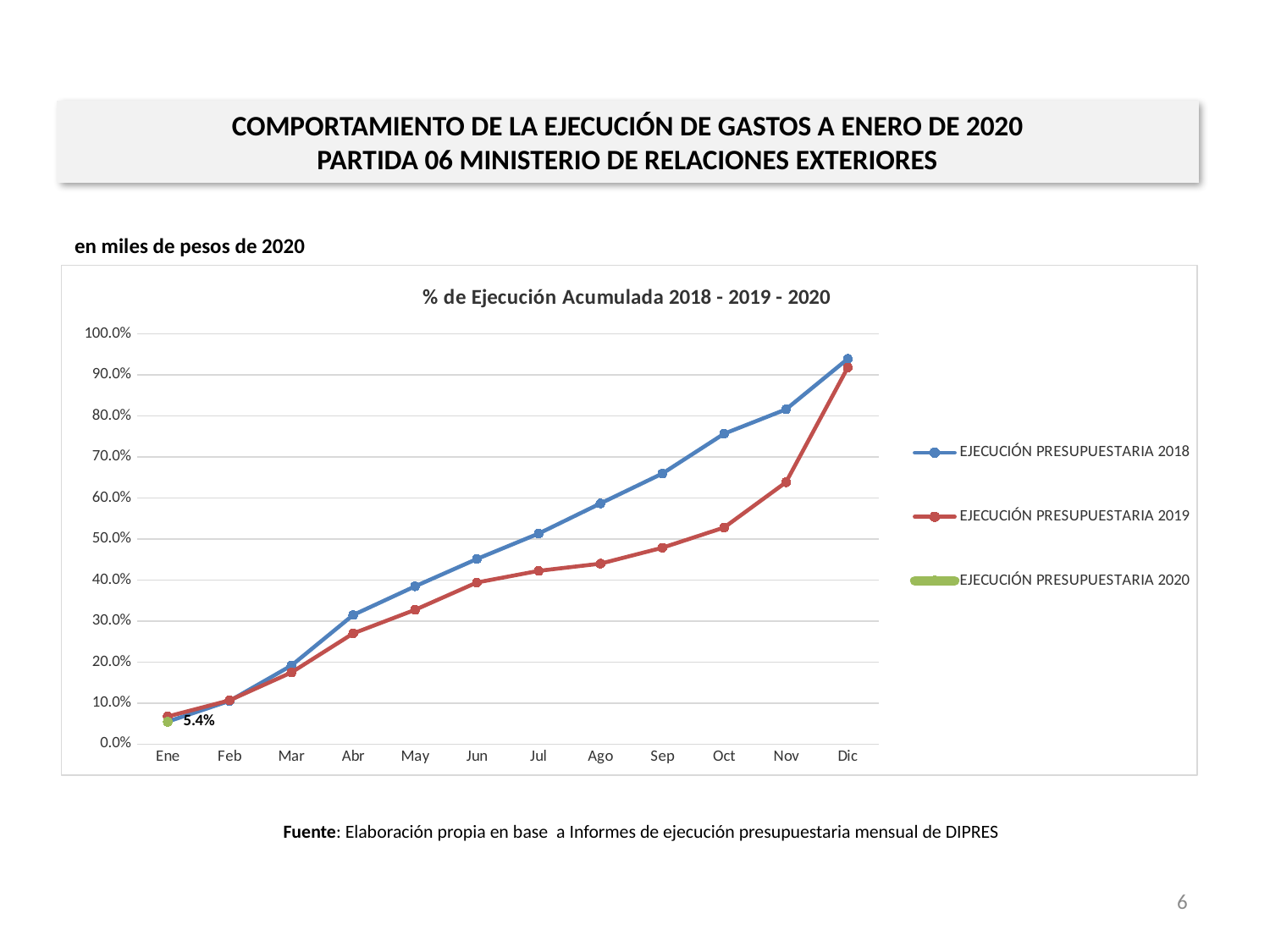
In which month is EJECUCIÓN PRESUPUESTARIA 2019 at its lowest value? Ene In Nov, which series is larger: EJECUCIÓN PRESUPUESTARIA 2018 or EJECUCIÓN PRESUPUESTARIA 2019? EJECUCIÓN PRESUPUESTARIA 2018 What is the title of the chart? % de Ejecución Acumulada 2018 - 2019 - 2020 What kind of chart is shown on the slide? line chart Is the value for EJECUCIÓN PRESUPUESTARIA 2019 in Jul greater or less than 50.0%? less Do the values for EJECUCIÓN PRESUPUESTARIA 2018 rise or fall from Ene to Dic? rise In which month does EJECUCIÓN PRESUPUESTARIA 2018 reach its highest value? Dic Is the value for EJECUCIÓN PRESUPUESTARIA 2018 in Oct greater or less than 70.0%? greater How many series does the legend list? 3 What is the value for EJECUCIÓN PRESUPUESTARIA 2020 in Ene? 5.4% Which colour is used for the EJECUCIÓN PRESUPUESTARIA 2019 line? red How many months are shown on the x axis? 12